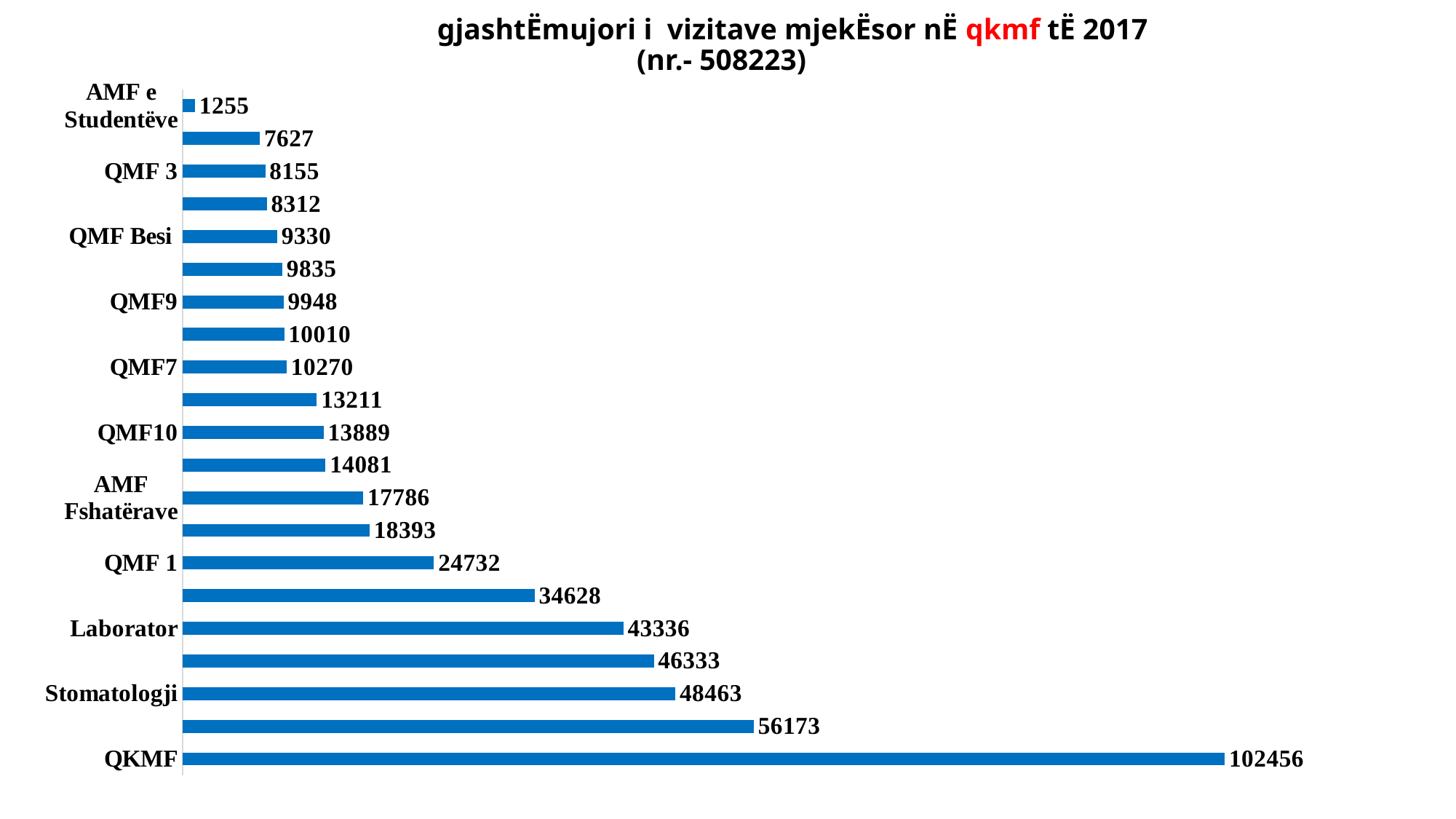
What type of chart is shown on the slide? bar chart What is the value for QKMF? 102456 What is the difference between the values for QKMF and Stomatologji? 53993 What is the value for AMF Fshatërave? 17786 How many bars are plotted in the chart? 21 What is the value for Laborator? 43336 What total number is given in parentheses in the chart title? 508223 Which category has the lowest value? AMF e Studentëve Which category has the highest value? QKMF What is the value for QMF Besi? 9330 What is the value for Stomatologji? 48463 Which is larger, the value for QMF 1 or the value for QMF10? QMF 1